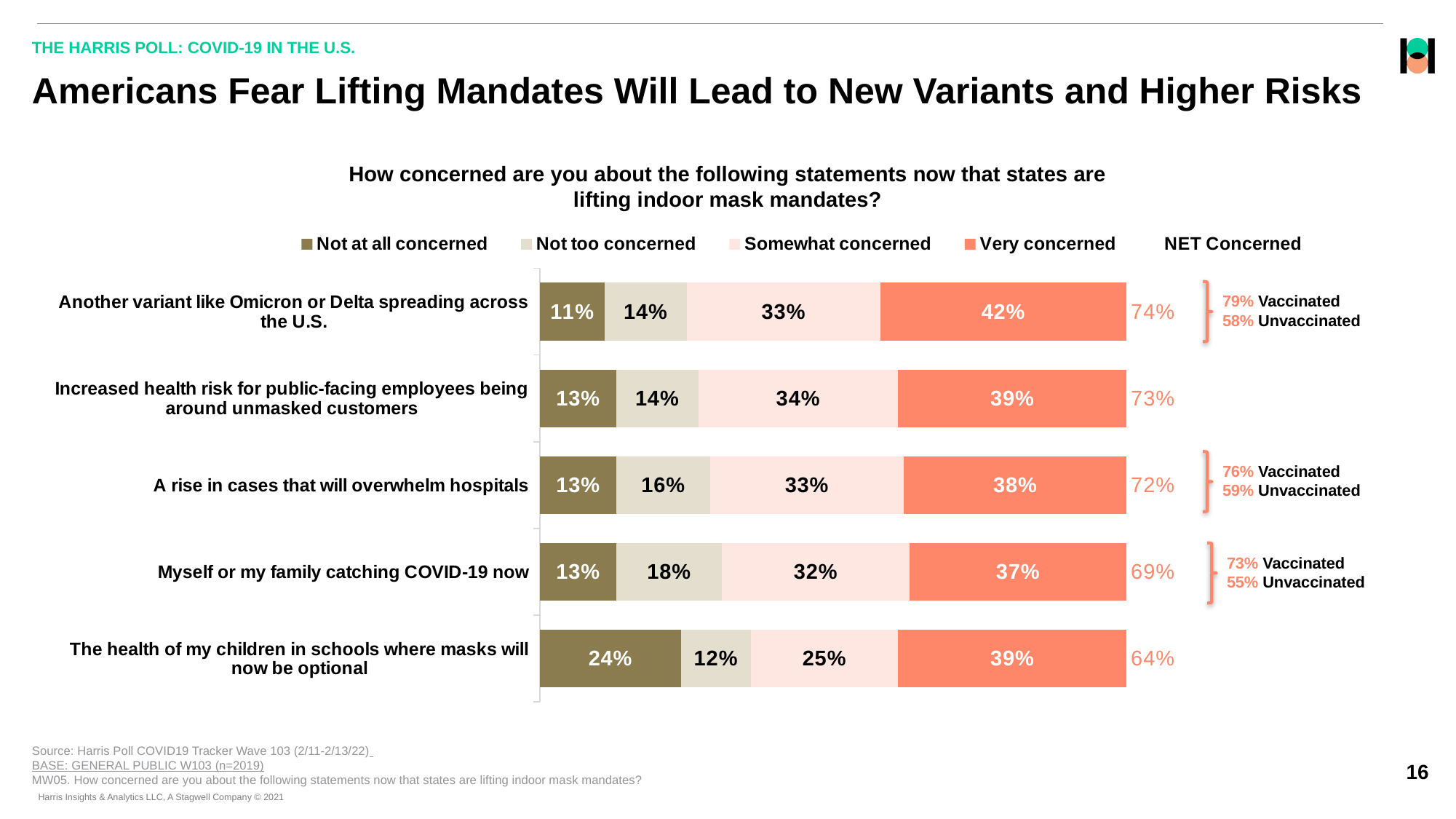
What is the NET Concerned value for "A rise in cases that will overwhelm hospitals"? 72% What is the total of the "Somewhat concerned" and "Very concerned" segments for "Increased health risk for public-facing employees being around unmasked customers"? 73% Which is larger: the "Not too concerned" value for "Myself or my family catching COVID-19 now" or for "A rise in cases that will overwhelm hospitals"? Myself or my family catching COVID-19 now Which statement has the lowest NET Concerned value? The health of my children in schools where masks will now be optional How many concern levels does the legend list as bar segments? 4 What is the difference between the "Very concerned" values for "Another variant like Omicron or Delta spreading across the U.S." and "Myself or my family catching COVID-19 now"? 5 percentage points Which statement has the highest NET Concerned value? Another variant like Omicron or Delta spreading across the U.S. How many statements (categories) are shown in the chart? 5 What percentage of respondents are "Not at all concerned" about the health of their children in schools where masks will now be optional? 24% What percentage of vaccinated respondents are NET Concerned about another variant like Omicron or Delta spreading across the U.S.? 79% What type of chart is shown on the slide? Stacked horizontal bar chart What percentage of respondents are "Very concerned" about another variant like Omicron or Delta spreading across the U.S.? 42%